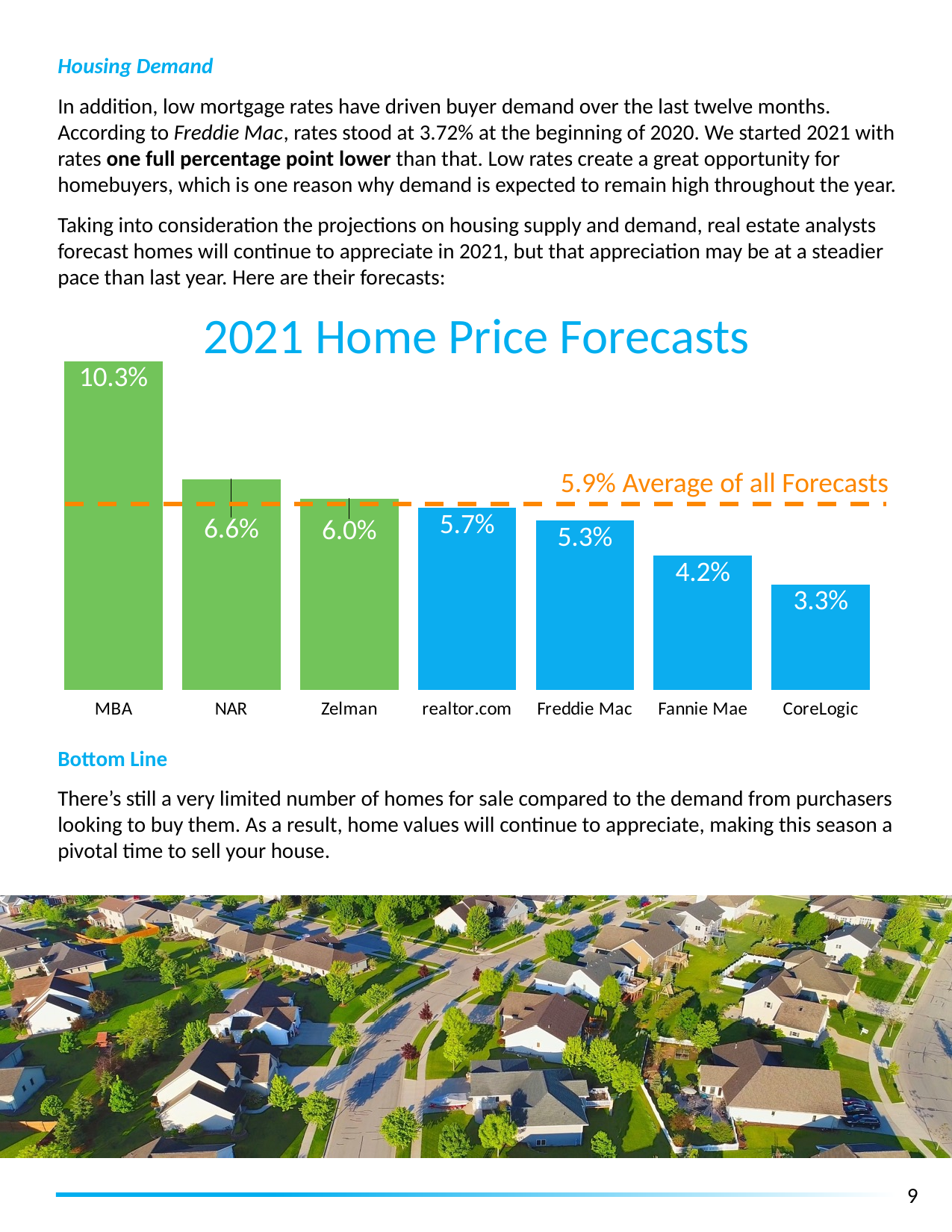
Which forecast is larger, realtor.com or Fannie Mae? realtor.com What is the 2021 home price forecast from Freddie Mac? 5.3% What is the 2021 home price forecast from MBA? 10.3% Which forecaster has the highest 2021 home price forecast? MBA Do the forecast values rise or fall from left to right across the chart? Fall What is the difference between the NAR forecast and the Fannie Mae forecast? 2.4% What is the 2021 home price forecast from CoreLogic? 3.3% How many forecasters are shown in the chart? 7 What is the average of all forecasts shown by the dashed line? 5.9% What is the title of the chart? 2021 Home Price Forecasts What kind of chart is used to show the 2021 home price forecasts? Bar chart Which forecaster has the lowest 2021 home price forecast? CoreLogic